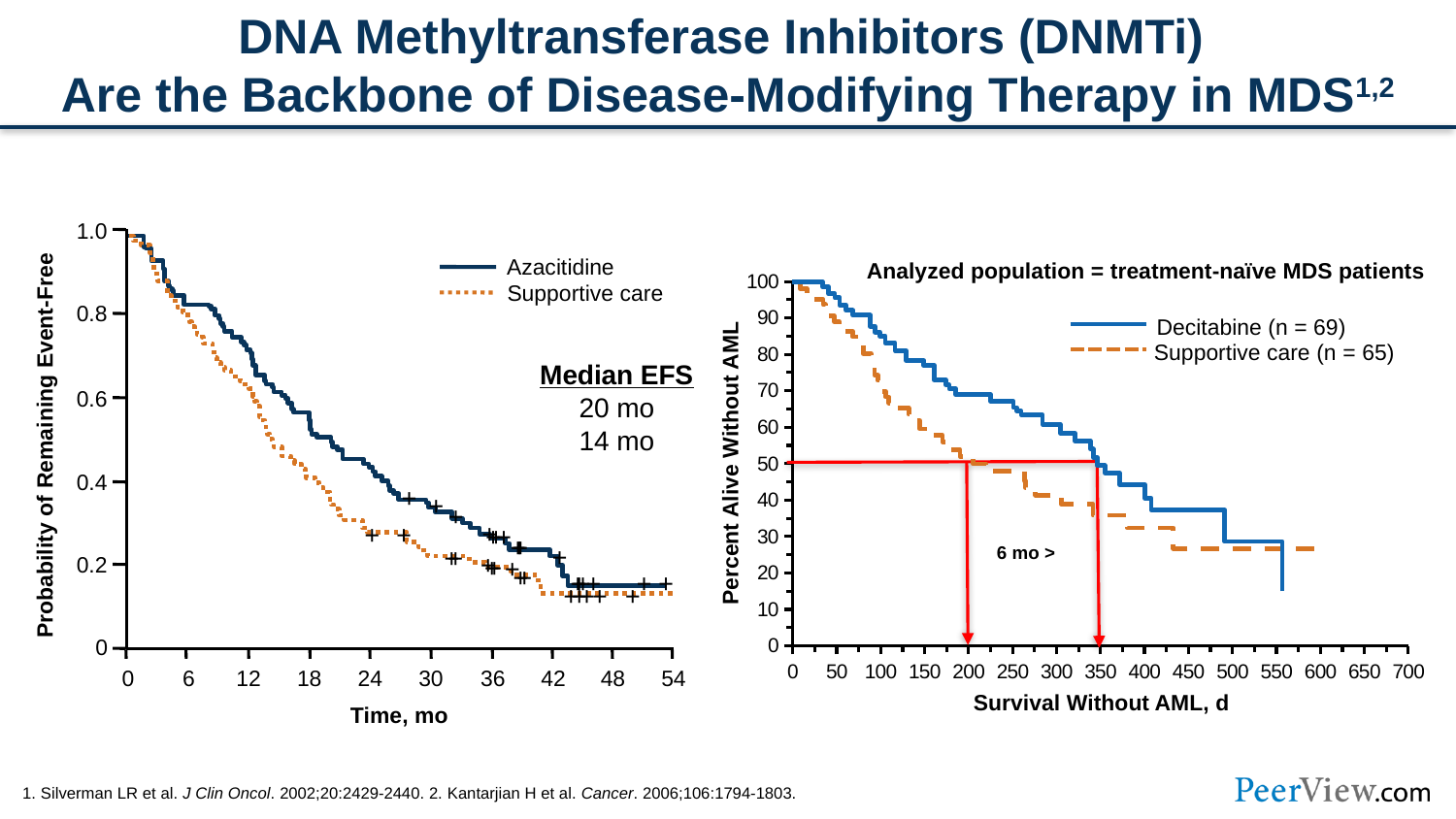
On the left chart, is the supportive care probability at 30 months greater or less than 0.4? less On the left chart, what is the x-axis label? Time, mo On the left chart, is the azacitidine probability at 12 months greater or less than 0.6? greater On the right chart, how many patients were in the decitabine group? 69 On the right chart, how many patients were in the supportive care group? 65 On the left chart, what is the median EFS for azacitidine? 20 mo On the right chart, do the curves rise or fall as survival time increases? fall On the left chart, what is the median EFS for supportive care? 14 mo On the left chart, which treatment has the longer median EFS? Azacitidine On the right chart, at 300 days, which group has the higher percent alive without AML? Decitabine On the left chart, how many series does the legend list? 2 On the left chart, what is the difference in median EFS between azacitidine and supportive care? 6 mo